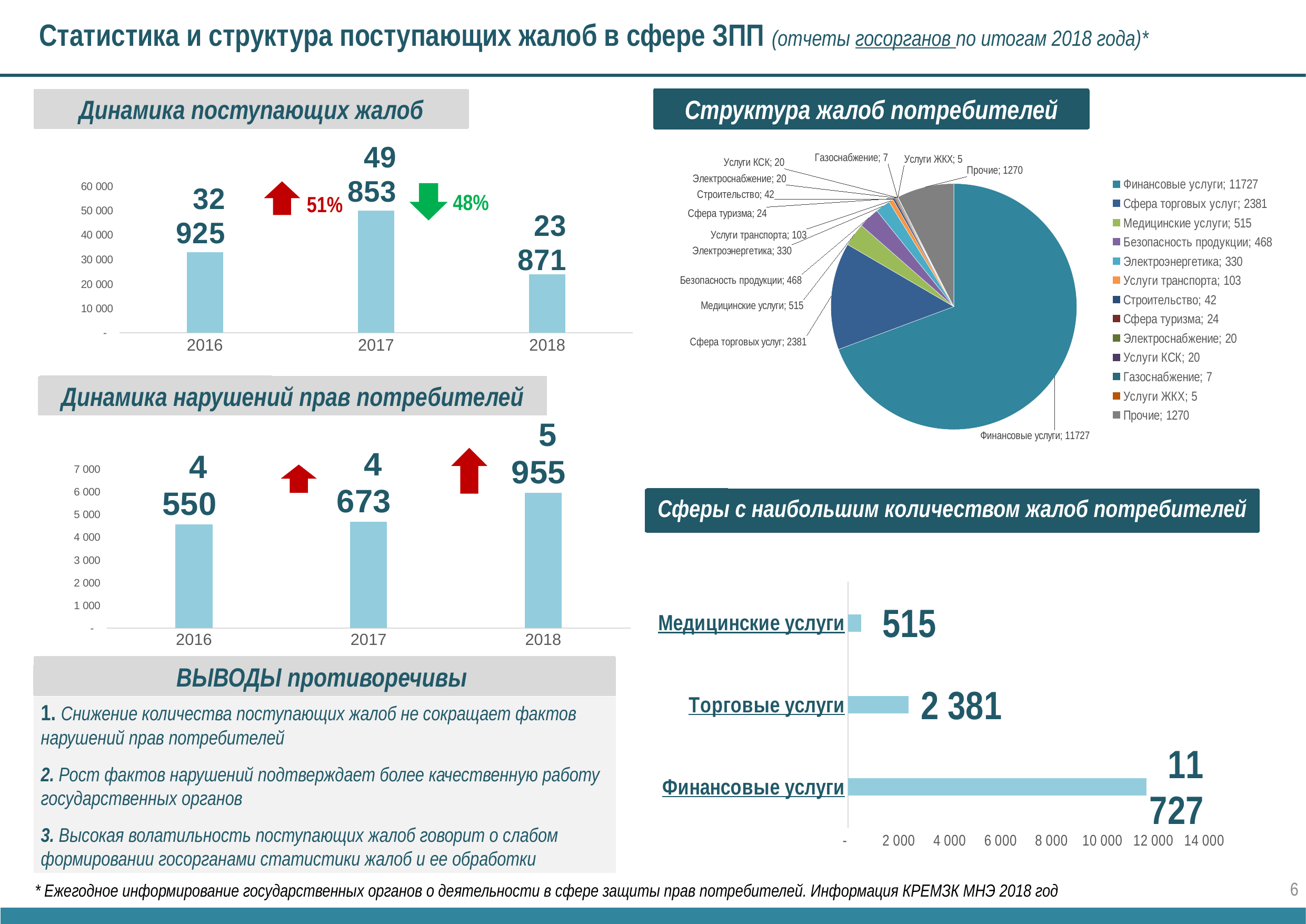
On the 'Динамика поступающих жалоб' chart, what is the difference between the 2017 and 2018 values? 25 982 On the 'Динамика поступающих жалоб' chart, what is the value for 2017? 49 853 On the 'Динамика нарушений прав потребителей' chart, do the values rise or fall from 2016 to 2018? rise On the 'Структура жалоб потребителей' pie chart, what is the value for Медицинские услуги? 515 On the 'Сферы с наибольшим количеством жалоб потребителей' chart, which is larger: Торговые услуги or Медицинские услуги? Торговые услуги On the 'Структура жалоб потребителей' pie chart, which category has the largest slice? Финансовые услуги On the 'Динамика поступающих жалоб' chart, which year has the lowest value? 2018 On the 'Динамика нарушений прав потребителей' chart, what is the difference between the 2018 and 2016 values? 1 405 On the 'Динамика нарушений прав потребителей' chart, which year has the highest value? 2018 On the 'Структура жалоб потребителей' pie chart, how many categories does the legend list? 13 On the 'Динамика нарушений прав потребителей' chart, what is the value for 2016? 4 550 What kind of chart is 'Сферы с наибольшим количеством жалоб потребителей'? bar chart